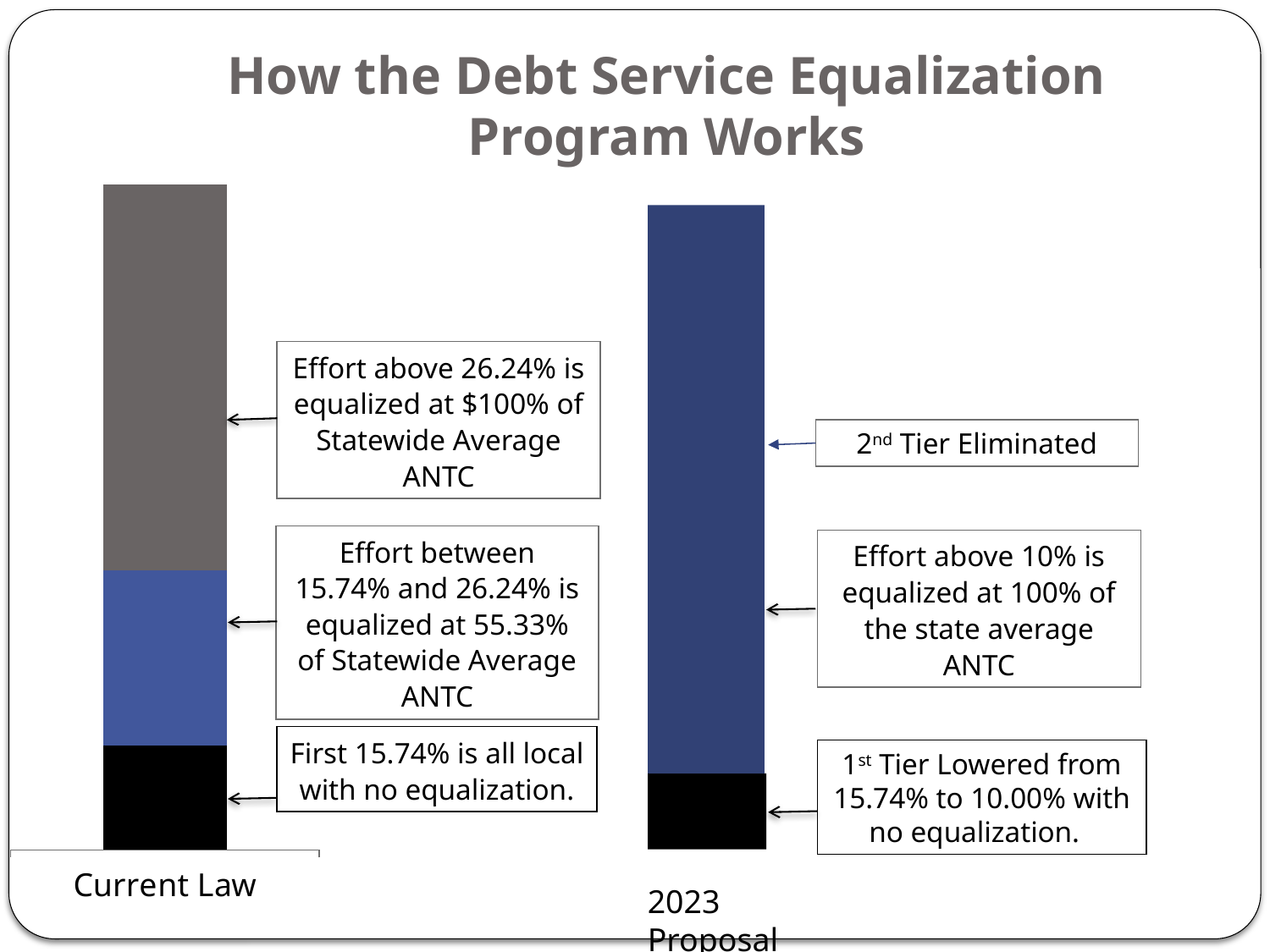
How many segments make up the Current Law bar? 3 Which segment of the Current Law bar is the smallest? The black segment What is the title of the chart? How the Debt Service Equalization Program Works What is the label of the left bar? Current Law How many segments make up the 2023 Proposal bar? 2 What kind of chart is shown on the slide? Stacked bar chart Which bar has more segments, Current Law or 2023 Proposal? Current Law Which segment of the 2023 Proposal bar is the largest? The blue segment Which segment of the Current Law bar is the largest? The gray segment How many bars are plotted on the chart? 2 What colour is the bottom segment of the Current Law bar? Black What is the label of the right bar? 2023 Proposal